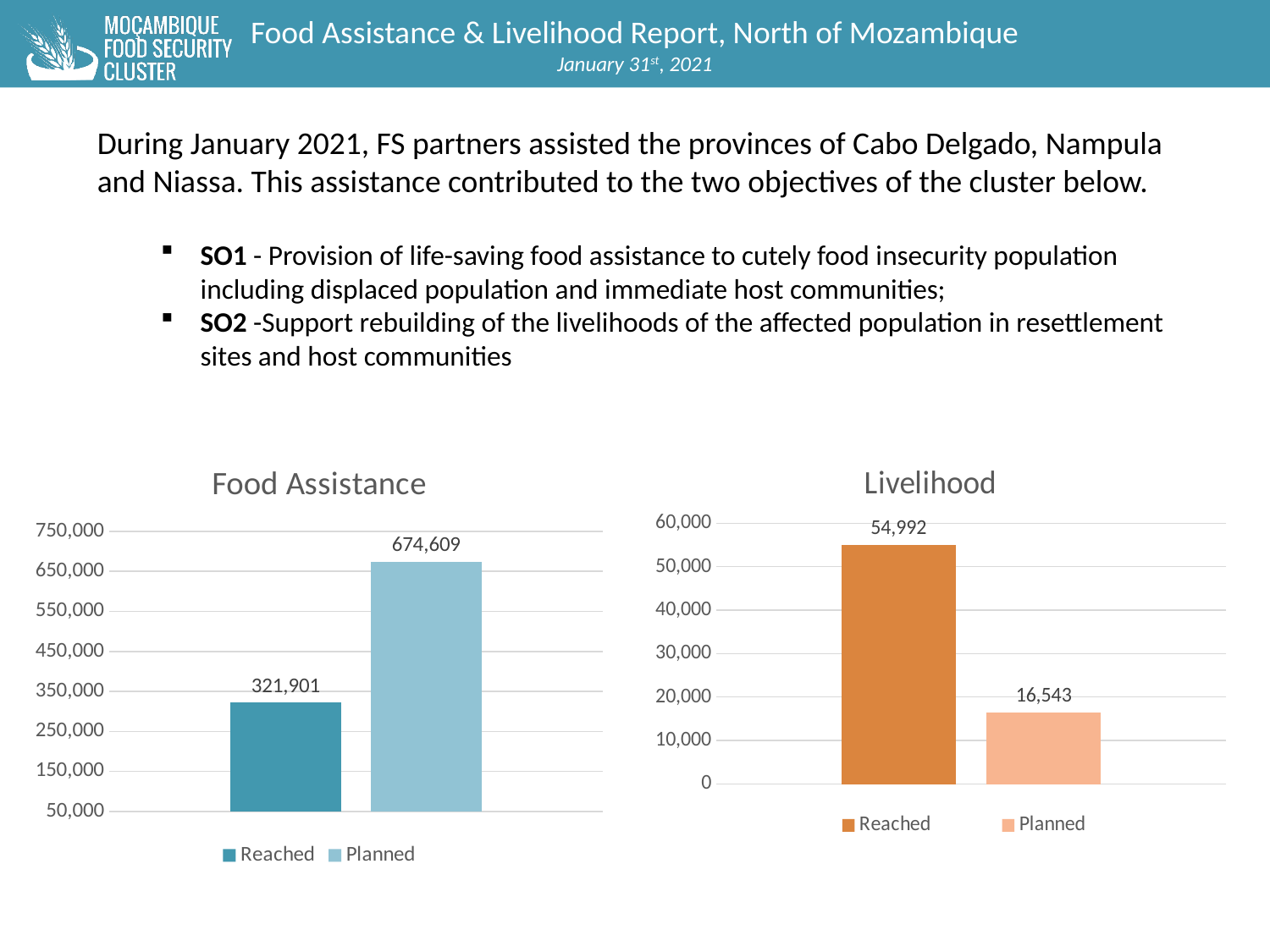
How many series does the legend of the Food Assistance chart list? 2 In the Food Assistance chart, what is the value for Planned? 674,609 In the Food Assistance chart, is the value for Reached greater or less than 350,000? less In the Livelihood chart, what is the difference between Reached and Planned? 38,449 In the Livelihood chart, which series has the lower value? Planned In the Food Assistance chart, what is the value for Reached? 321,901 In the Livelihood chart, is Reached larger or smaller than Planned? larger In the Livelihood chart, what is the value for Planned? 16,543 In the Livelihood chart, what is the value for Reached? 54,992 In the Food Assistance chart, what is the difference between Planned and Reached? 352,708 What kind of chart is the Livelihood chart? bar chart In the Food Assistance chart, which series has the higher value? Planned